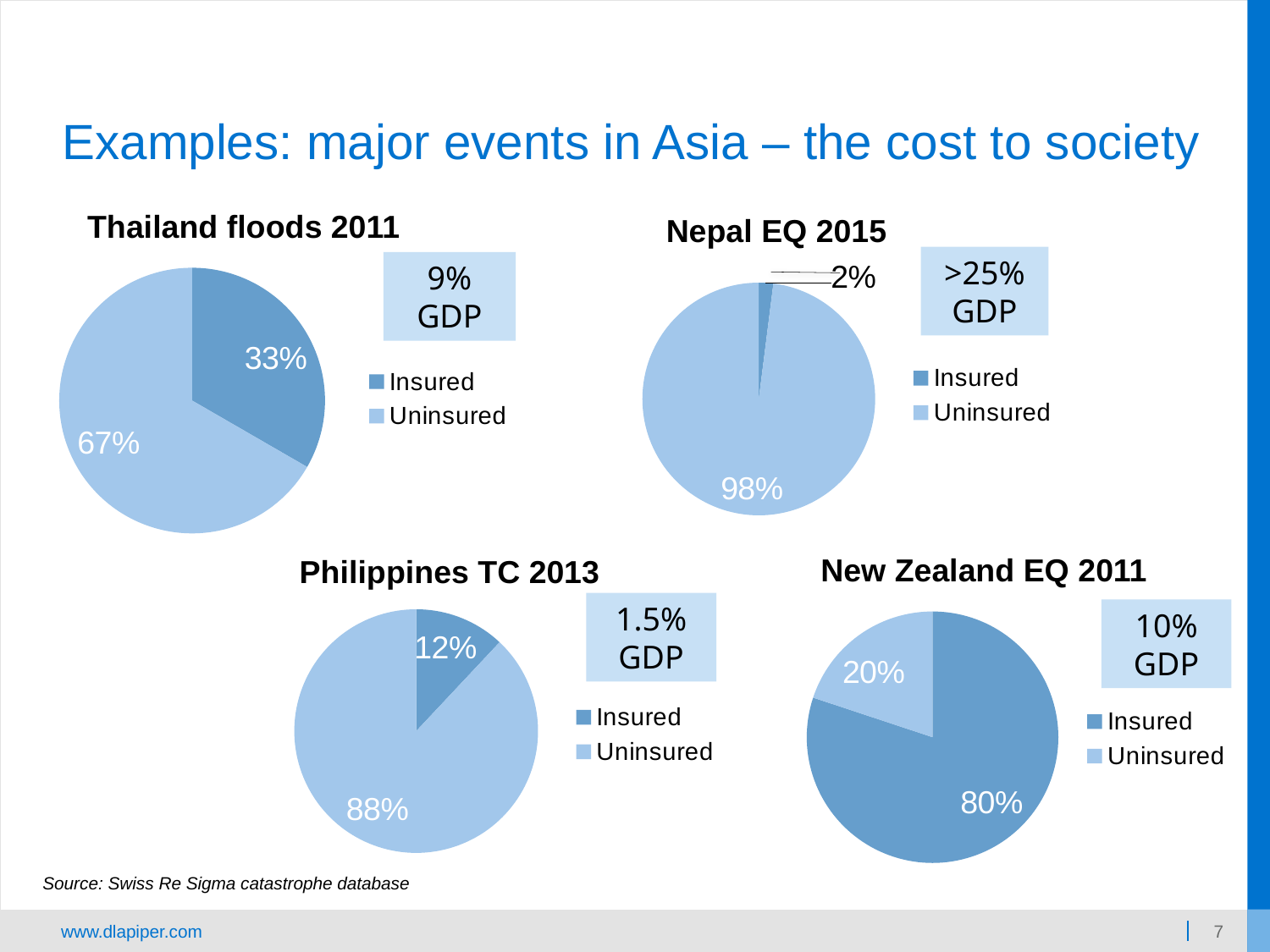
In the Thailand floods 2011 pie chart, what share is Uninsured? 67% In the Nepal EQ 2015 pie chart, what share is Uninsured? 98% What kind of chart is used for Philippines TC 2013? Pie chart In the Thailand floods 2011 pie chart, what share is Insured? 33% In the Nepal EQ 2015 pie chart, what share is Insured? 2% How many entries does the legend of the New Zealand EQ 2011 chart list? 2 In the Philippines TC 2013 pie chart, which slice is the largest? Uninsured In the Philippines TC 2013 pie chart, what share is Insured? 12% In the New Zealand EQ 2011 pie chart, which slice is larger, Insured or Uninsured? Insured How many slices does the Nepal EQ 2015 pie chart have? 2 In the Thailand floods 2011 pie chart, what is the difference between the Uninsured and Insured shares? 34% In the New Zealand EQ 2011 pie chart, what share is Insured? 80%